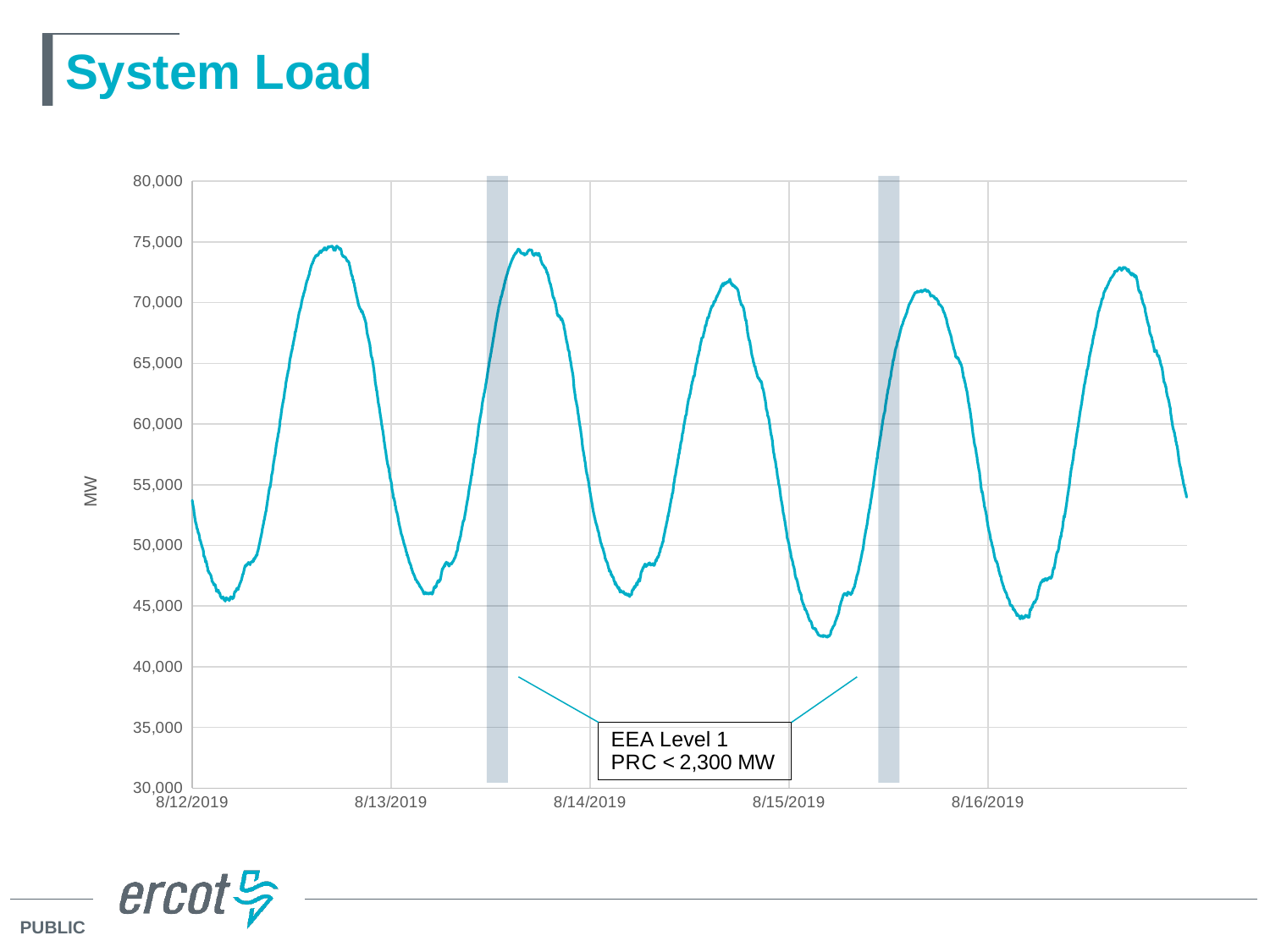
Is the peak load on 8/16/2019 greater or less than 70,000? greater Is the peak load on 8/15/2019 greater or less than 75,000? less Is the lowest load on 8/13/2019 greater or less than 50,000? less Which daily trough is lower, the one on 8/12/2019 or the one on 8/15/2019? 8/15/2019 What is the label on the vertical axis of the chart? MW How many date labels are shown along the x axis? 5 What does the annotation box on the chart say? EEA Level 1 PRC < 2,300 MW What kind of chart is shown on the slide? line chart Which daily peak is higher, the one on 8/12/2019 or the one on 8/15/2019? 8/12/2019 On which date does the load reach its lowest trough? 8/15/2019